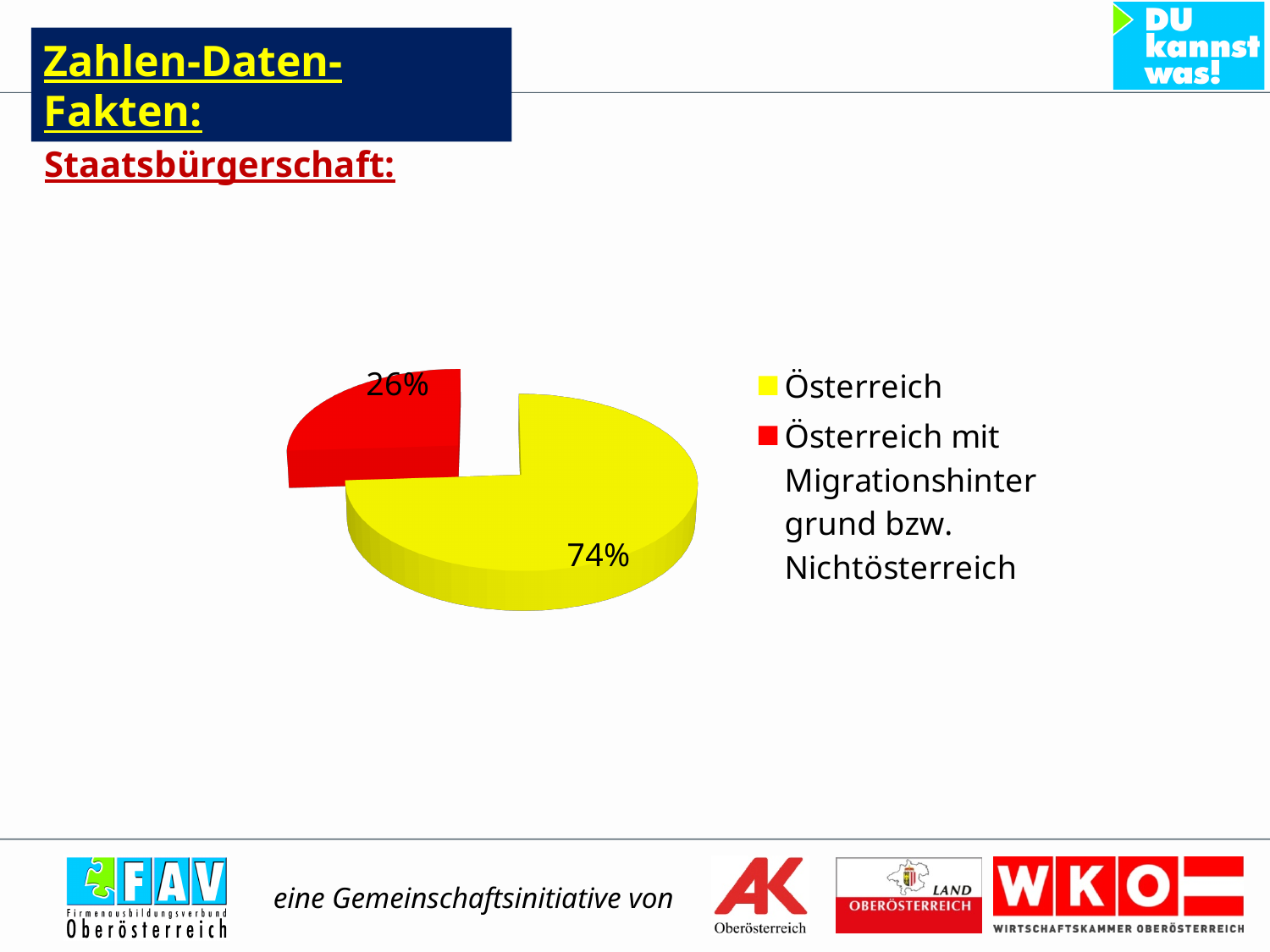
What colour is the Österreich mit Migrationshintergrund bzw. Nichtösterreich slice? red What colour is the Österreich slice? yellow Is the share for Österreich greater or less than 50%? greater Which category has the largest slice of the pie? Österreich How many entries does the legend list? 2 What share of the pie does Österreich have? 74% What share of the pie does Österreich mit Migrationshintergrund bzw. Nichtösterreich have? 26% How many slices does the pie chart have? 2 Which is larger: the Österreich slice or the Österreich mit Migrationshintergrund bzw. Nichtösterreich slice? Österreich What is the difference in percentage points between the Österreich slice and the Österreich mit Migrationshintergrund bzw. Nichtösterreich slice? 48 What type of chart is shown on the slide? pie chart Which category has the smallest slice of the pie? Österreich mit Migrationshintergrund bzw. Nichtösterreich